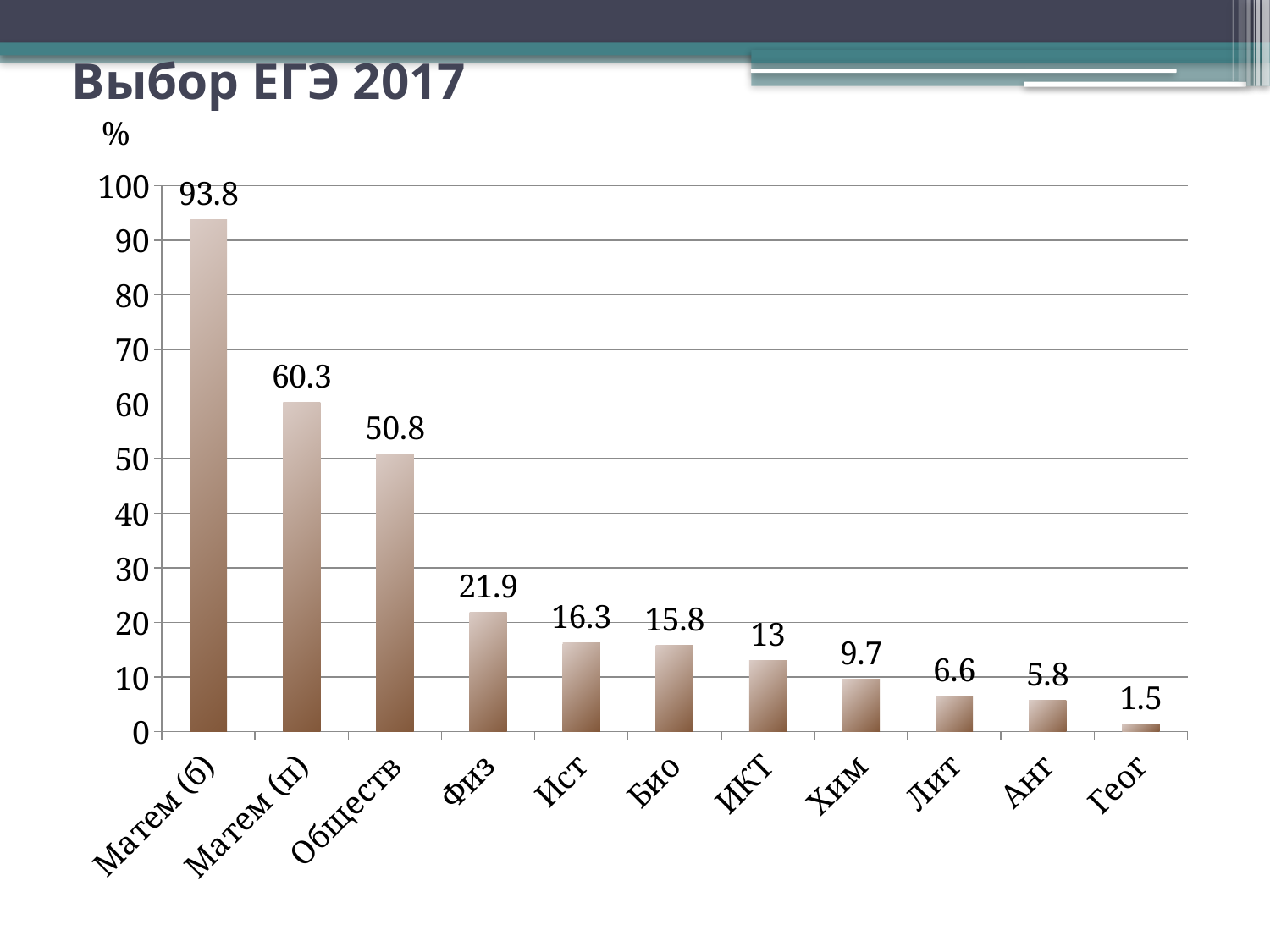
What is the value for ИКТ? 13 What kind of chart is shown on the slide? bar chart What is the difference between the values for Матем (б) and Матем (п)? 33.5 Which category has the lowest value? Геог What is the title of the slide? Выбор ЕГЭ 2017 What is the value for Геог? 1.5 Which is larger, the value for Физ or the value for Ист? Физ Is the value for Хим greater or less than 10? less Which category has the highest value? Матем (б) How many categories are shown on the x axis? 11 What is the value for Обществ? 50.8 What is the value for Матем (б)? 93.8